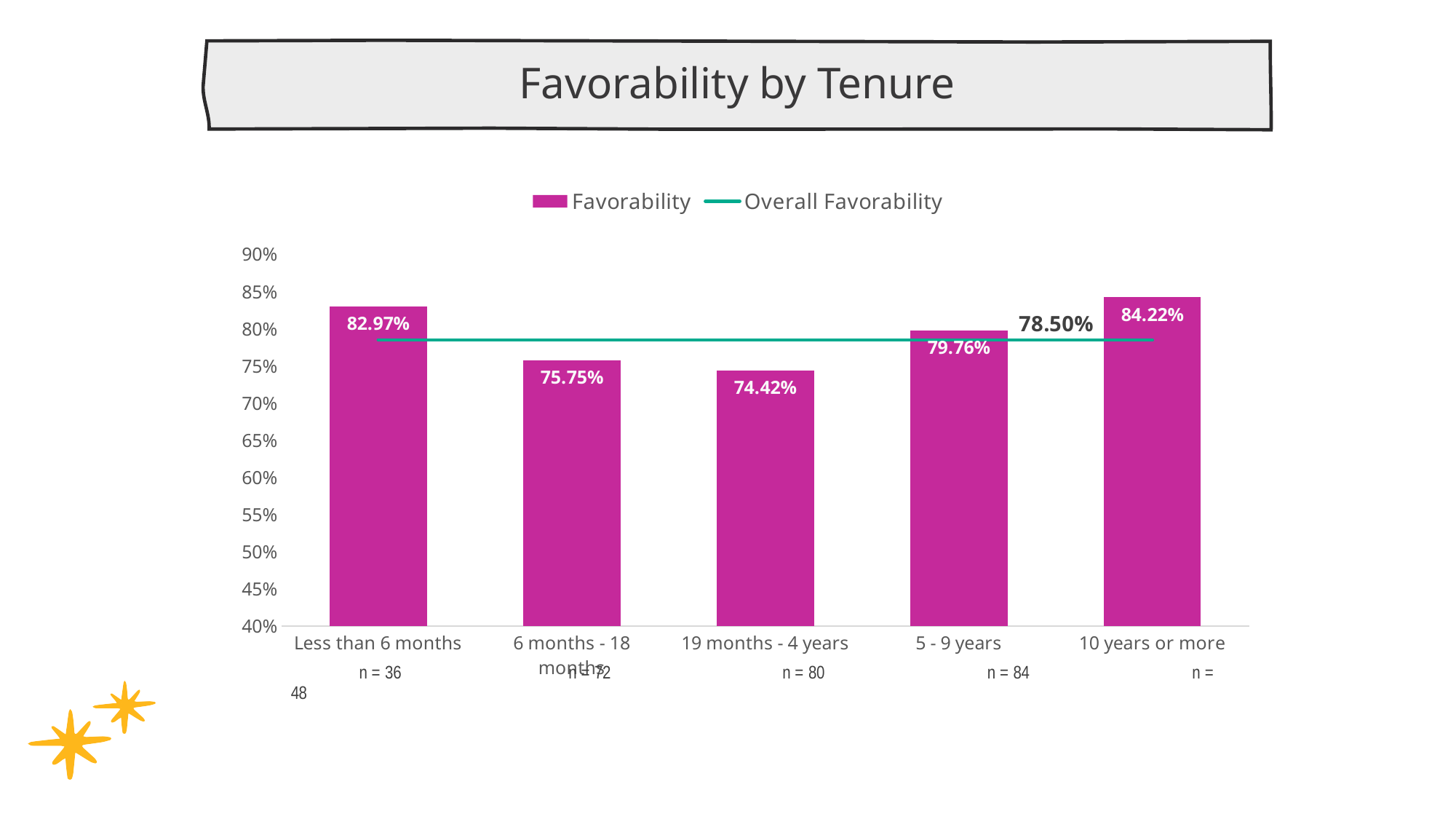
Which tenure group has the highest Favorability? 10 years or more What is the Favorability value for the '19 months - 4 years' tenure group? 74.42% Which has a higher Favorability: '6 months - 18 months' or '5 - 9 years'? 5 - 9 years What is the title of the chart? Favorability by Tenure What is the Favorability value for the 'Less than 6 months' tenure group? 82.97% What is the Favorability value for the '5 - 9 years' tenure group? 79.76% How many series does the legend list? 2 What is the difference in Favorability between the '10 years or more' group and the '19 months - 4 years' group? 9.80% Which tenure group has the lowest Favorability? 19 months - 4 years What is the Overall Favorability value shown on the chart? 78.50% How many tenure groups are shown on the chart? 5 What kind of chart is used to show Favorability by tenure group? Bar chart